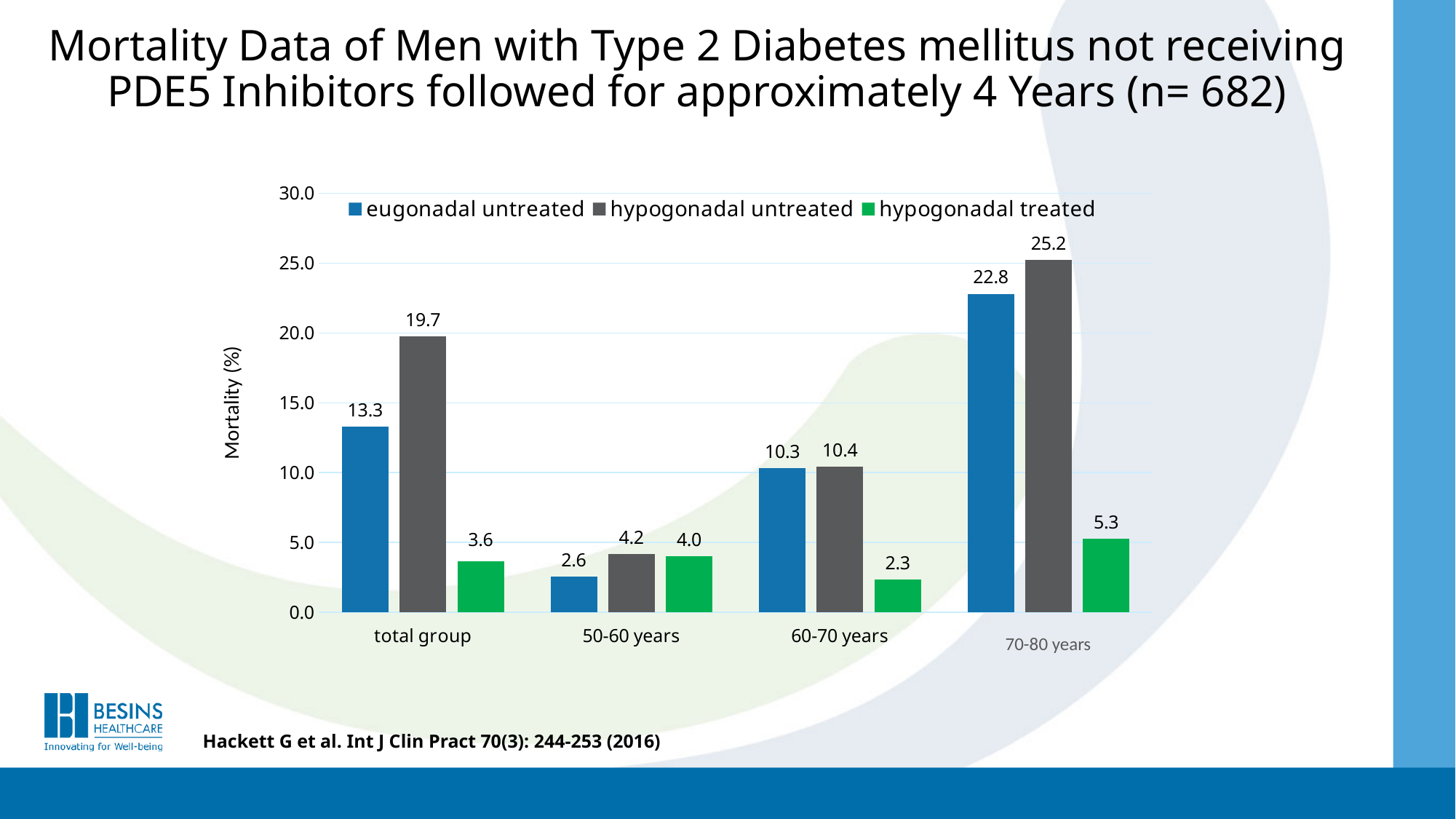
Which category has the lowest mortality for eugonadal untreated men? 50-60 years What is the mortality (%) for hypogonadal untreated men in the total group? 19.7 Which age category has the highest mortality for hypogonadal untreated men? 70-80 years In the 70-80 years group, which is larger: mortality for eugonadal untreated or hypogonadal treated men? eugonadal untreated What is the difference in mortality (%) between hypogonadal untreated and hypogonadal treated men in the total group? 16.1 How many age categories are shown on the x axis? 4 How many series does the legend list? 3 What is the label of the y axis? Mortality (%) What kind of chart is shown on the slide? bar chart Does mortality for hypogonadal untreated men rise or fall from the 50-60 years group to the 70-80 years group? rise What is the mortality (%) for eugonadal untreated men aged 70-80 years? 22.8 What is the mortality (%) for hypogonadal treated men aged 60-70 years? 2.3